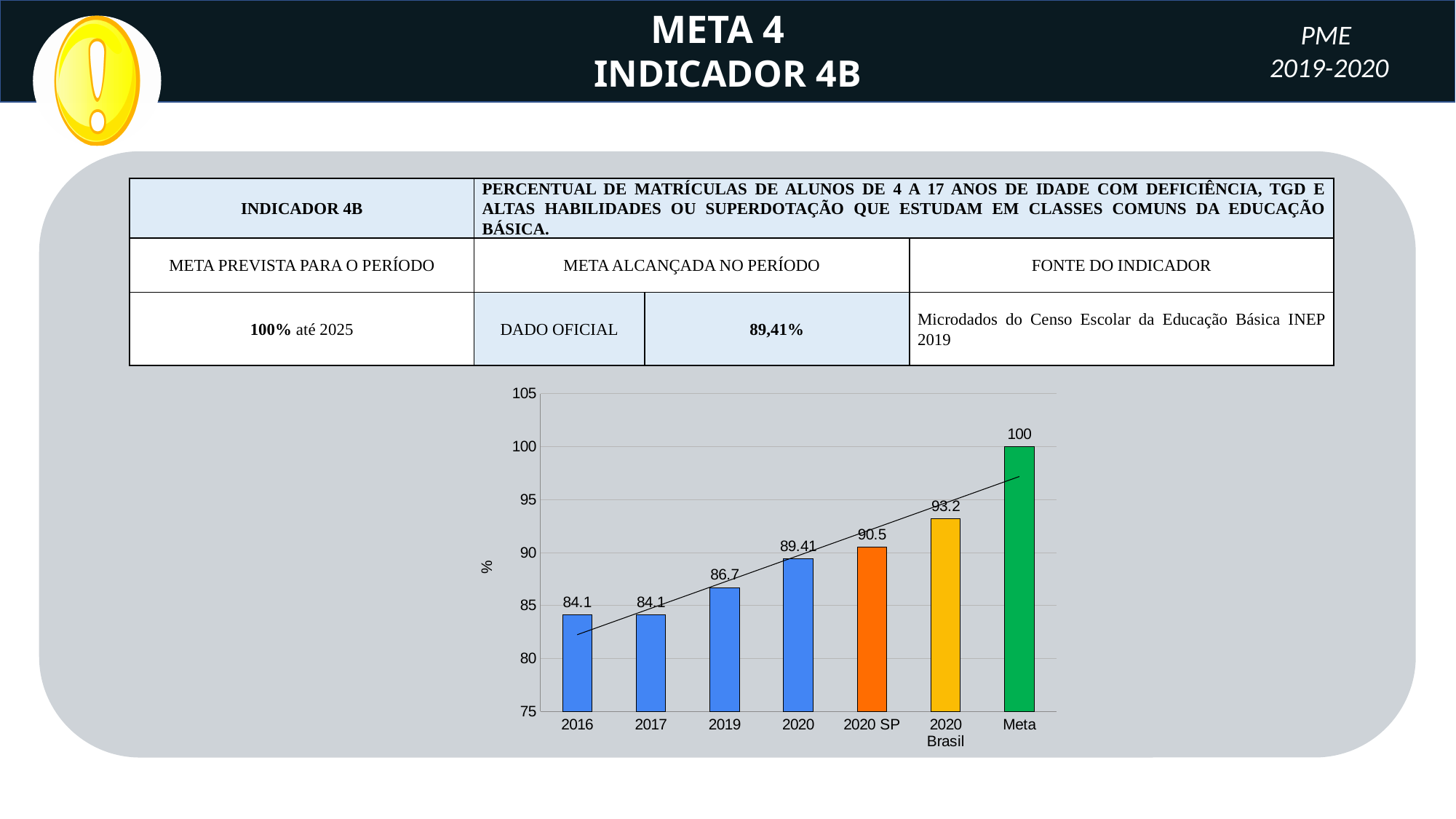
What is the difference between the 2020 Brasil value and the 2020 SP value? 2.7 Is the value for 2019 greater or less than 85? greater Which category has the highest value in the chart? Meta How many bars are shown in the chart? 7 What is the difference between the Meta value and the 2020 value? 10.59 What kind of chart is shown on the slide? bar chart What is the value for 2020 SP in the chart? 90.5 What is the lowest value shown in the chart? 84.1 What is the label on the vertical axis of the chart? % What is the value for 2020 Brasil in the chart? 93.2 Which is larger, the value for 2020 or the value for 2020 SP? 2020 SP What is the value for 2019 in the chart? 86.7